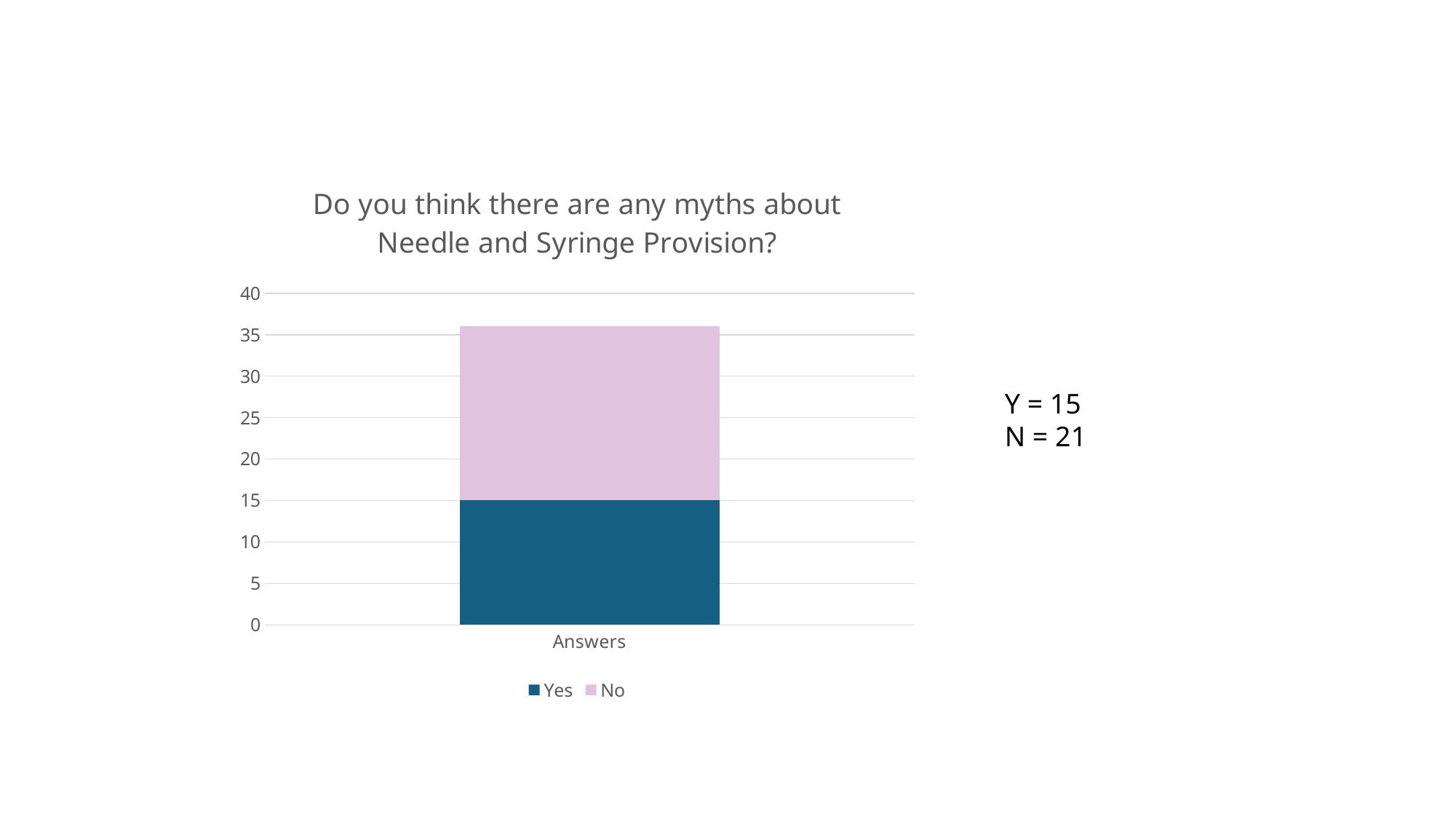
Is the total of the stacked bar greater or less than 30? greater What kind of chart is shown on the slide? Stacked bar chart What is the total height of the stacked bar for Answers? 36 Which is larger, the Yes value or the No value? No What is the value for Yes in the chart? 15 Is the value for Yes greater or less than 20? less What is the value for No in the chart? 21 What is the title of the chart? Do you think there are any myths about Needle and Syringe Provision? How many categories are shown on the x axis? 1 Which series is shown in dark blue in the chart? Yes How many series does the legend list? 2 What is the difference between the No value and the Yes value? 6